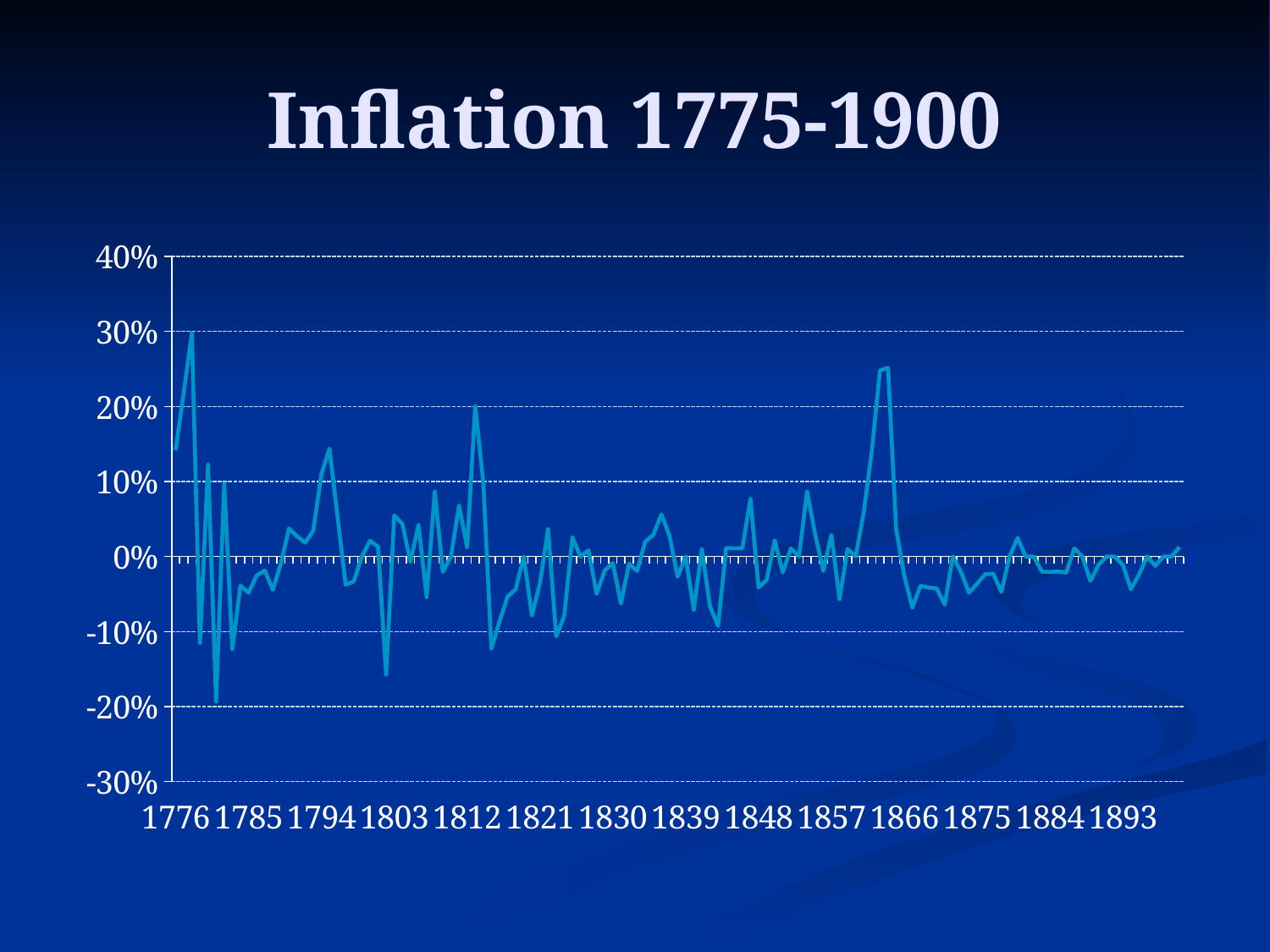
Is the value of the inflation line at the first x-axis label, 1776, greater or less than 10%? greater Is the lowest point of the inflation line greater or less than -30%? greater Is the lowest point of the inflation line greater or less than -10%? less What is the title of the chart? Inflation 1775-1900 What is the highest value shown on the y axis of the chart? 40% What is the first year label on the x axis of the chart? 1776 Which is larger: the peak of the inflation line shortly after 1776 or the peak between 1857 and 1866? the peak shortly after 1776 How many year labels are shown along the x axis of the chart? 14 What kind of chart is shown on the slide? line chart